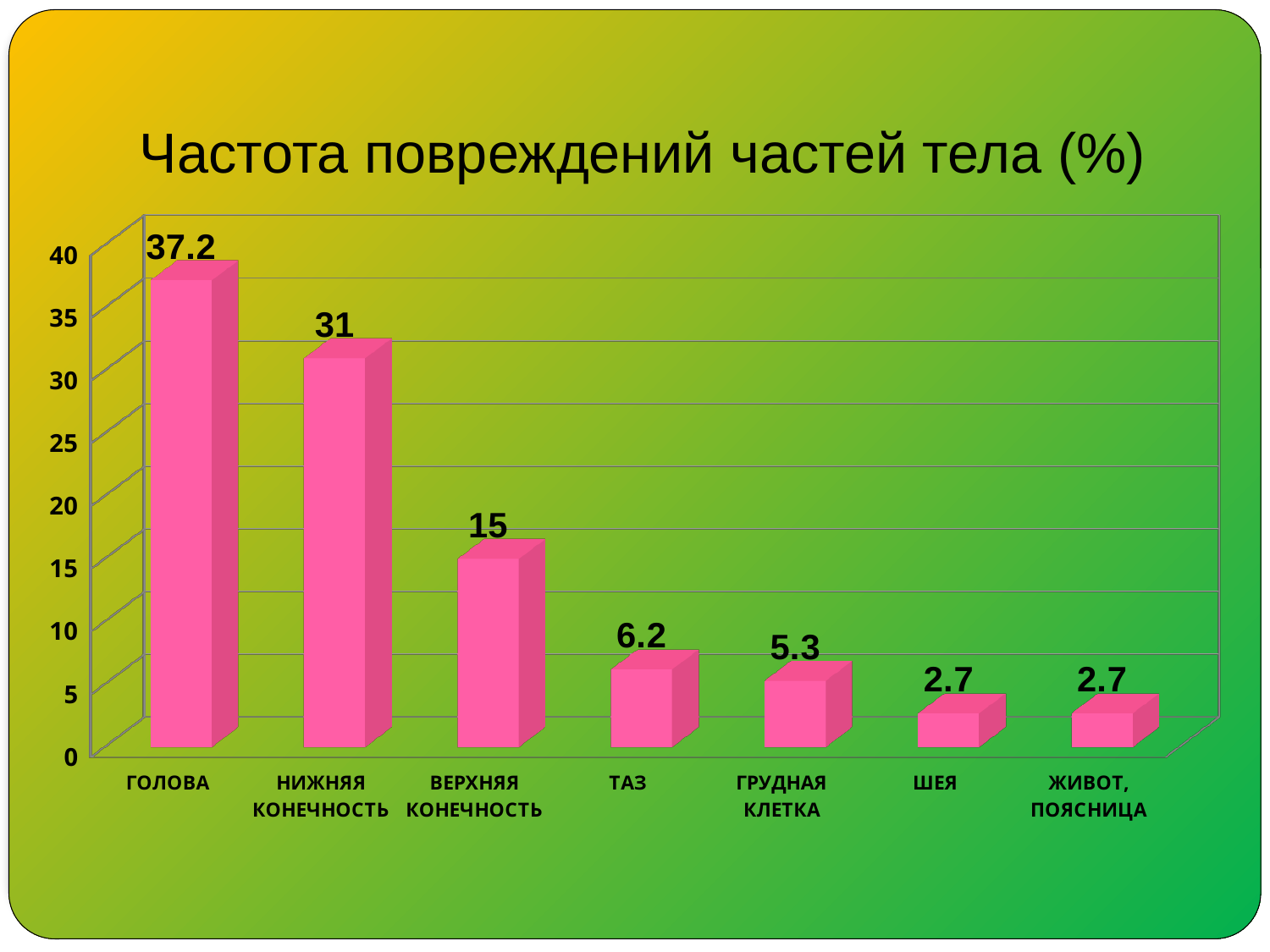
What is the title of the chart? Частота повреждений частей тела (%) What is the difference between the values for ТАЗ and ГРУДНАЯ КЛЕТКА? 0.9 Which category has the highest value? ГОЛОВА Do the values rise or fall from left to right along the x axis? fall What is the value for ГРУДНАЯ КЛЕТКА? 5.3 What is the value for ВЕРХНЯЯ КОНЕЧНОСТЬ? 15 How many categories are shown on the x axis? 7 Is the value for НИЖНЯЯ КОНЕЧНОСТЬ greater or less than 30? greater What is the difference between the values for ГОЛОВА and НИЖНЯЯ КОНЕЧНОСТЬ? 6.2 What kind of chart is shown on the slide? bar chart Which is larger, the value for ВЕРХНЯЯ КОНЕЧНОСТЬ or the value for ТАЗ? ВЕРХНЯЯ КОНЕЧНОСТЬ What is the value for ГОЛОВА? 37.2